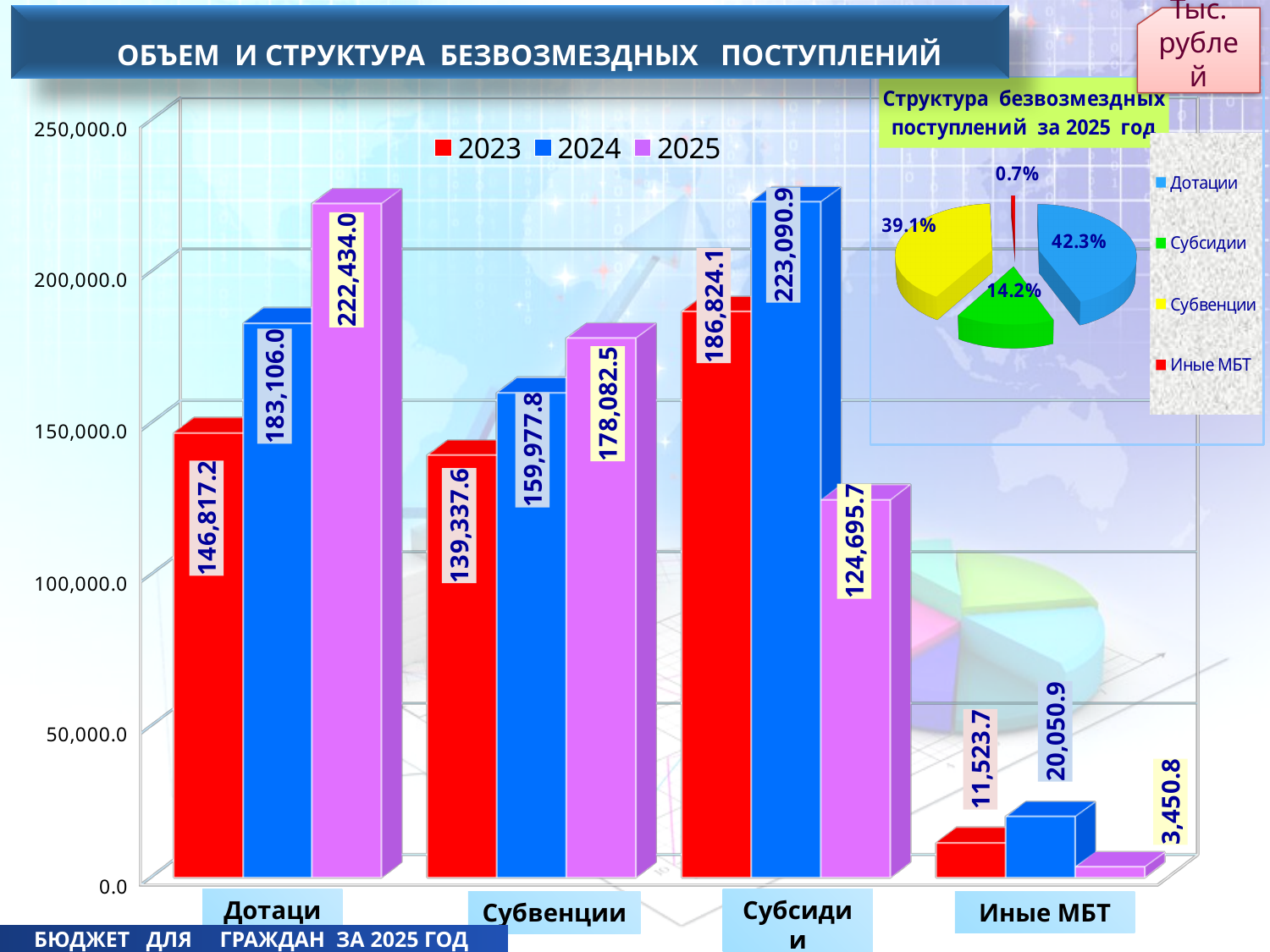
In the bar chart, what is the value for Иные МБТ in 2023? 11,523.7 In the bar chart, which category has the highest value in 2024? Субсидии In the bar chart, do the values for Субсидии rise or fall from 2024 to 2025? fall In the bar chart, which is larger: Субсидии in 2023 or Дотации in 2023? Субсидии in 2023 In the bar chart, what is the difference between the 2025 and 2023 values for Субвенции? 38,744.9 How many categories are shown on the x axis of the bar chart? 4 In the pie chart titled 'Структура безвозмездных поступлений за 2025 год', which category has the largest share? Дотации In the bar chart, what is the value for Субсидии in 2024? 223,090.9 In the bar chart, what is the value for Дотации in 2025? 222,434.0 How many series does the legend of the bar chart list? 3 In the bar chart, which category has the lowest value in 2025? Иные МБТ In the pie chart titled 'Структура безвозмездных поступлений за 2025 год', what share does Субвенции have? 39.1%